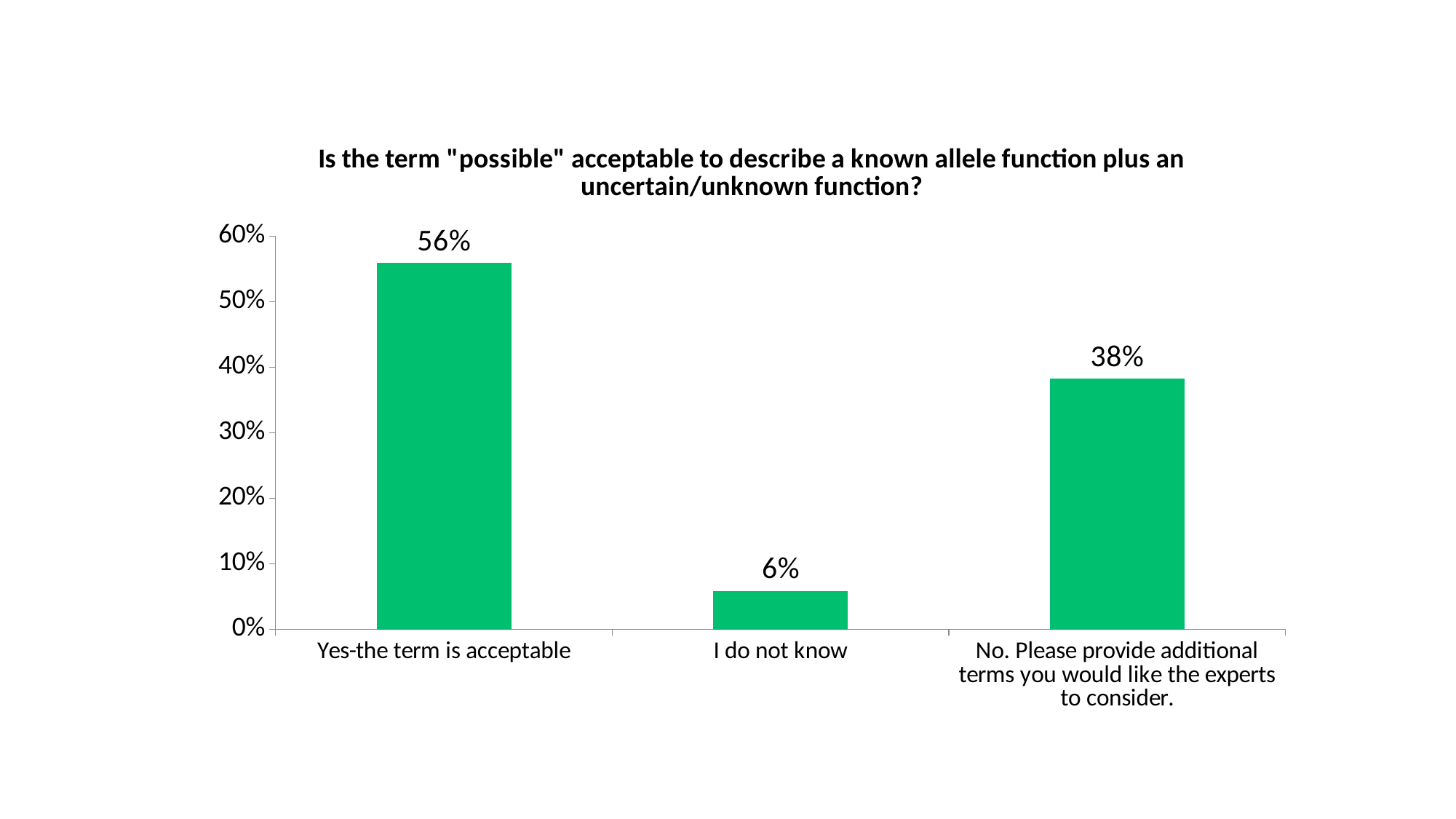
What is the difference in percentage points between "Yes-the term is acceptable" and the "No" option? 18% Which response category has the highest percentage? Yes-the term is acceptable Which response category has the lowest percentage? I do not know How many response categories are shown on the chart? 3 Is the value for "Yes-the term is acceptable" greater or less than 50%? greater What percentage of respondents answered "I do not know"? 6% Which is larger: the percentage for "I do not know" or the percentage for the "No" option? No. Please provide additional terms you would like the experts to consider. What percentage of respondents chose the "No. Please provide additional terms you would like the experts to consider." option? 38% What is the title of the chart? Is the term "possible" acceptable to describe a known allele function plus an uncertain/unknown function? What is the difference in percentage points between the "No" option and "I do not know"? 32% What kind of chart is shown on the slide? Bar chart What percentage of respondents answered "Yes-the term is acceptable"? 56%